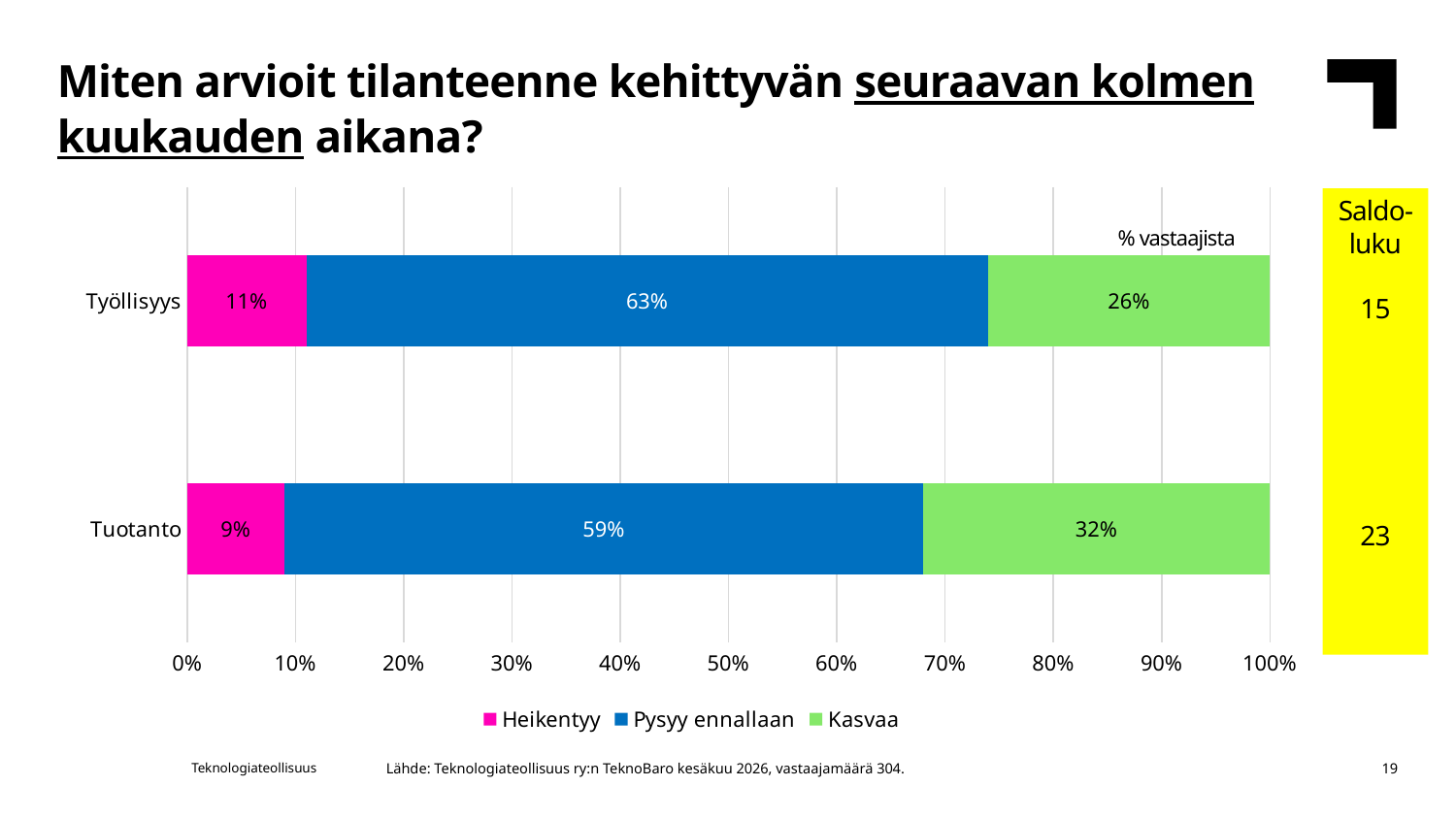
How many categories are shown on the y axis of the chart? 2 What is the Pysyy ennallaan value for Tuotanto? 59% What is the Kasvaa value for Työllisyys? 26% What is the difference between the Kasvaa values for Tuotanto and Työllisyys? 6% Which category has the higher Kasvaa share, Työllisyys or Tuotanto? Tuotanto What is the difference between the Pysyy ennallaan values for Työllisyys and Tuotanto? 4% Which category has the lower Heikentyy share? Tuotanto How many series does the legend list? 3 What kind of chart is shown on the slide? Stacked bar chart What is the Saldoluku value shown for Tuotanto? 23 What percentage of respondents expect Työllisyys to Heikentyy? 11% What is the Kasvaa value for Tuotanto? 32%